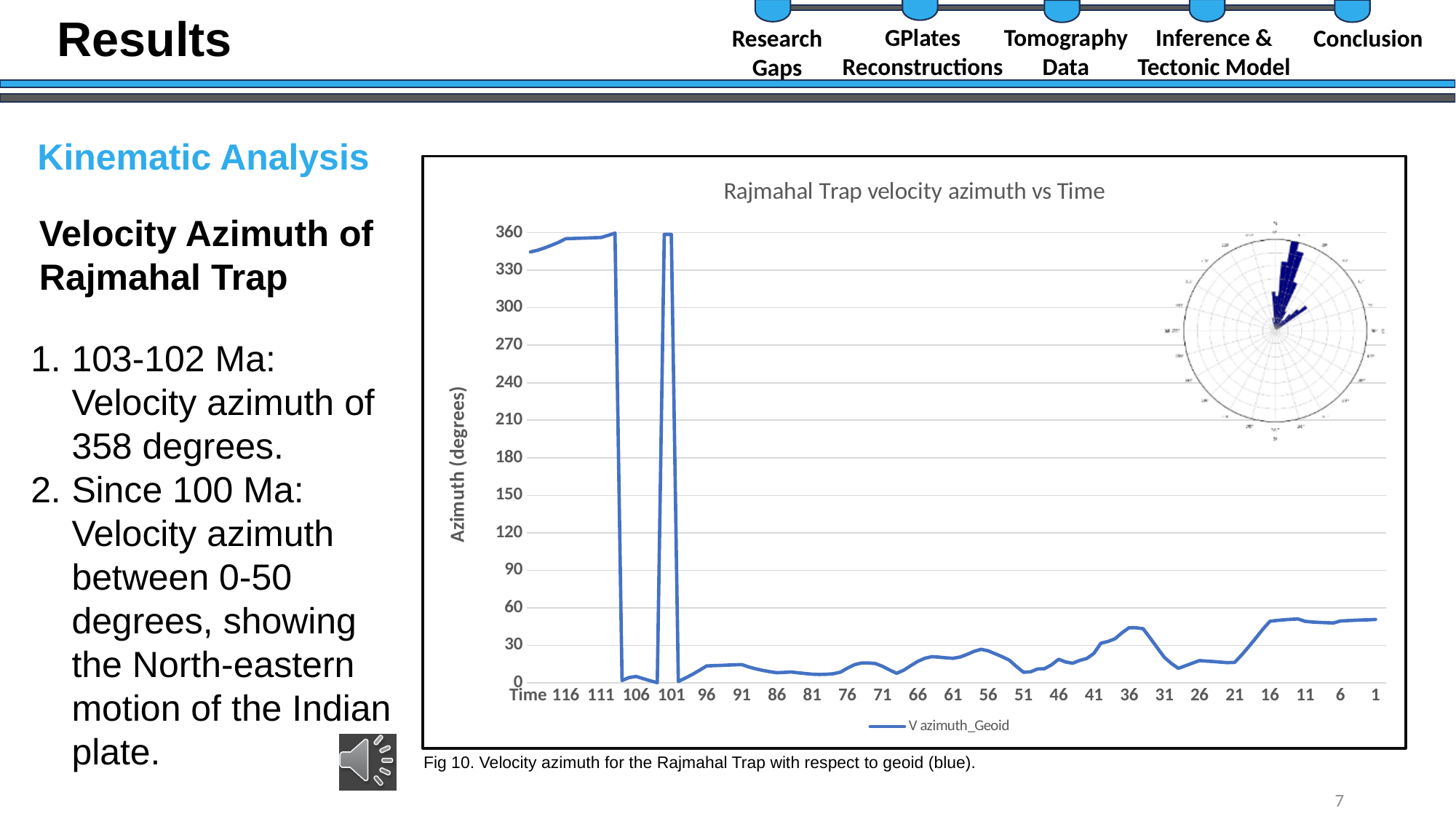
Is the value for 116 greater or less than 300? greater Which has the larger value, 36 or 81? 36 Is the value for 96 greater or less than 60? less What kind of chart is shown on the slide? line chart Is the value for 6 greater or less than 30? greater What is the name of the series shown in the chart legend? V azimuth_Geoid Do the values rise or fall between 26 and 16 on the x axis? rise What is the title of the chart? Rajmahal Trap velocity azimuth vs Time How many series does the chart legend list? 1 Which has the larger value, 116 or 1? 116